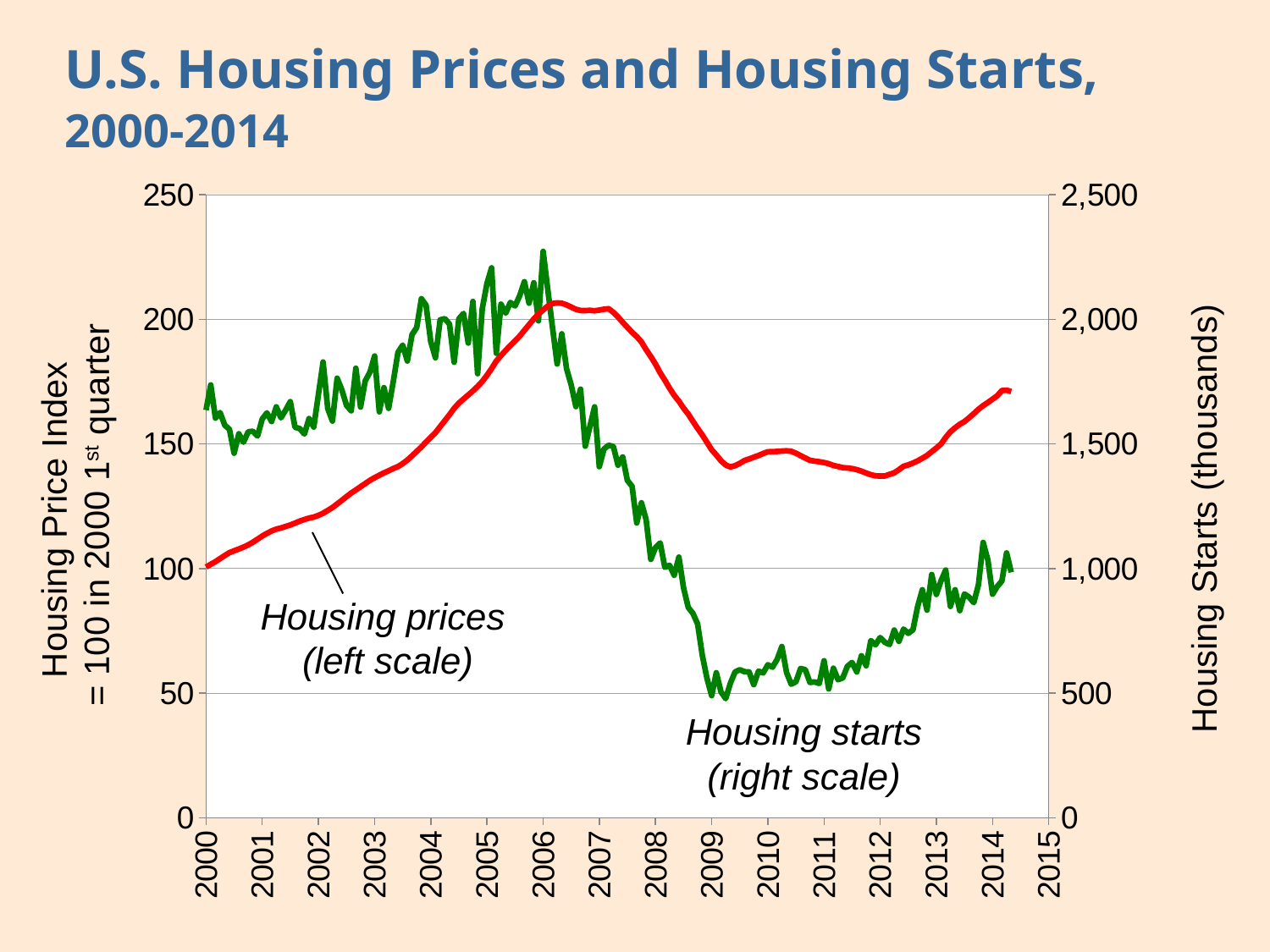
Which series is plotted against the right scale? Housing starts What is the label of the right vertical axis? Housing Starts (thousands) Do housing prices rise or fall between 2000 and 2006? rise Are housing starts in 2011 greater or less than 1,000 thousand? less What kind of chart is shown on the slide? line chart Is the Housing Price Index in 2012 greater or less than 150? less How many data series are plotted on the chart? 2 Are housing starts at the start of 2006 greater or less than 2,000 thousand? greater Do housing starts rise or fall between 2006 and 2009? fall In which year do housing prices reach their highest level? 2006